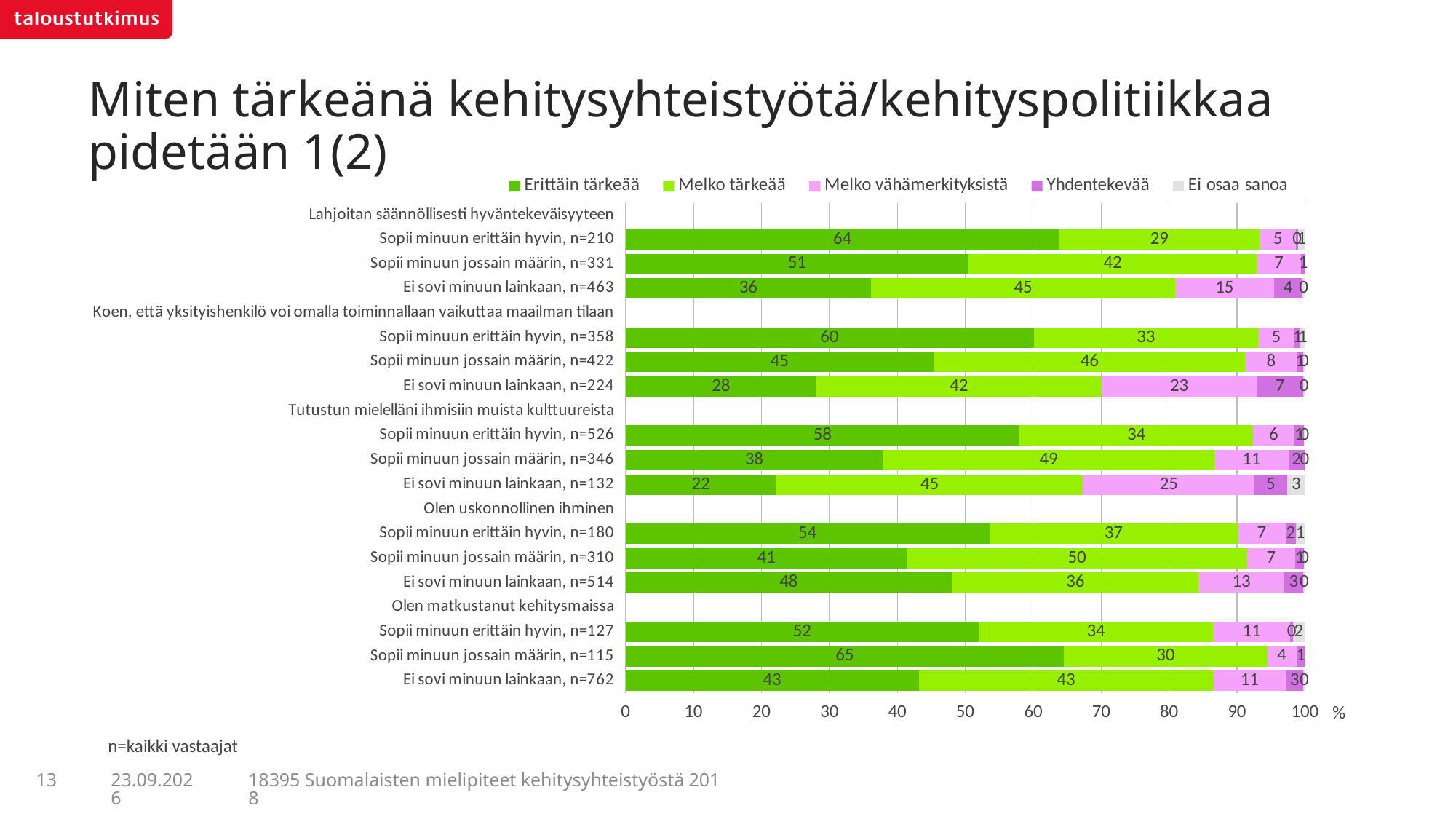
What is the 'Erittäin tärkeää' value for 'Olen uskonnollinen ihminen – Ei sovi minuun lainkaan, n=514'? 48 Within the group 'Lahjoitan säännöllisesti hyväntekeväisyyteen', what is the difference in 'Erittäin tärkeää' between 'Sopii minuun erittäin hyvin, n=210' and 'Ei sovi minuun lainkaan, n=463'? 28 Which has the larger 'Melko tärkeää' value: 'Koen, että yksityishenkilö voi omalla toiminnallaan vaikuttaa maailman tilaan – Sopii minuun jossain määrin, n=422' or 'Lahjoitan säännöllisesti hyväntekeväisyyteen – Sopii minuun jossain määrin, n=331'? Koen, että yksityishenkilö voi omalla toiminnallaan vaikuttaa maailman tilaan – Sopii minuun jossain määrin, n=422 Which row has the lowest 'Erittäin tärkeää' value? Tutustun mielelläni ihmisiin muista kulttuureista – Ei sovi minuun lainkaan, n=132 What is the 'Melko vähämerkityksistä' value for 'Tutustun mielelläni ihmisiin muista kulttuureista – Ei sovi minuun lainkaan, n=132'? 25 How many series does the legend list? 5 What percentage of respondents in the group 'Lahjoitan säännöllisesti hyväntekeväisyyteen – Sopii minuun erittäin hyvin, n=210' answered 'Erittäin tärkeää'? 64 What kind of chart is shown on the slide? Stacked bar chart Which row has the highest 'Erittäin tärkeää' value? Olen matkustanut kehitysmaissa – Sopii minuun jossain määrin, n=115 What is the 'Melko tärkeää' value for 'Olen uskonnollinen ihminen – Sopii minuun jossain määrin, n=310'? 50 Is the 'Melko vähämerkityksistä' value for 'Koen, että yksityishenkilö voi omalla toiminnallaan vaikuttaa maailman tilaan – Ei sovi minuun lainkaan, n=224' greater or less than 20? greater What colour represents 'Erittäin tärkeää' in the chart? Dark green